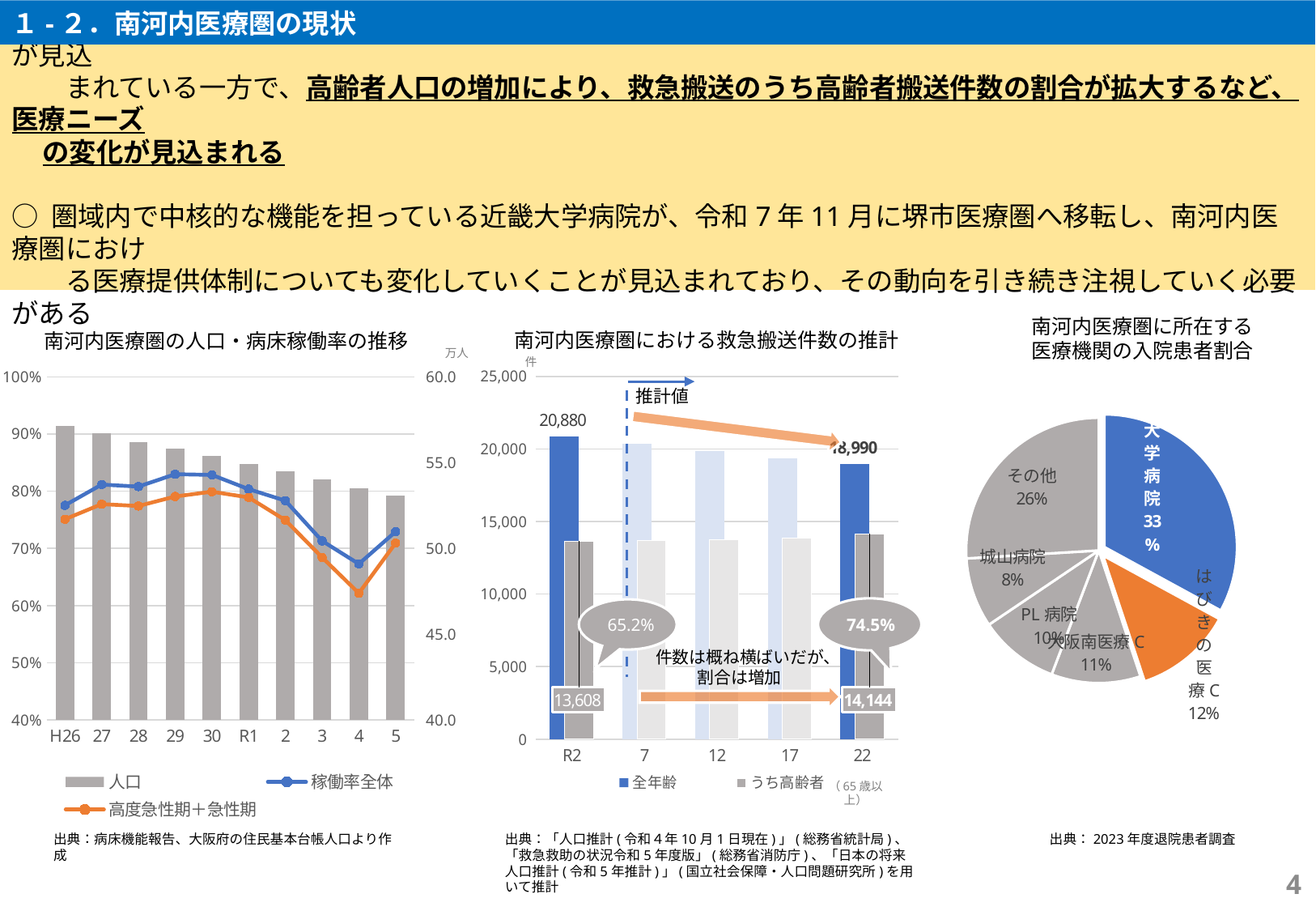
In the left chart (南河内医療圏の人口・病床稼働率の推移), how many series does the legend list? 3 In the middle chart (南河内医療圏における救急搬送件数の推計), how many series does the legend list? 2 In the middle chart (南河内医療圏における救急搬送件数の推計), what is the value for うち高齢者 in 22? 14,144 In the left chart (南河内医療圏の人口・病床稼働率の推移), is the 人口 value for H26 greater or less than 55.0? greater In the right chart (南河内医療圏に所在する医療機関の入院患者割合), how many slices does the pie have? 6 In the left chart (南河内医療圏の人口・病床稼働率の推移), do the 人口 bars rise or fall from H26 to 5? fall In the middle chart (南河内医療圏における救急搬送件数の推計), what is the value for うち高齢者 in R2? 13,608 In the middle chart (南河内医療圏における救急搬送件数の推計), how many categories are on the x axis? 5 In the right chart (南河内医療圏に所在する医療機関の入院患者割合), what share does 大学病院 have? 33% In the middle chart (南河内医療圏における救急搬送件数の推計), what is the difference between the うち高齢者 values for 22 and R2? 536 In the right chart (南河内医療圏に所在する医療機関の入院患者割合), which named hospital slice is the smallest? 城山病院 In the middle chart (南河内医療圏における救急搬送件数の推計), what is the value for 全年齢 in R2? 20,880